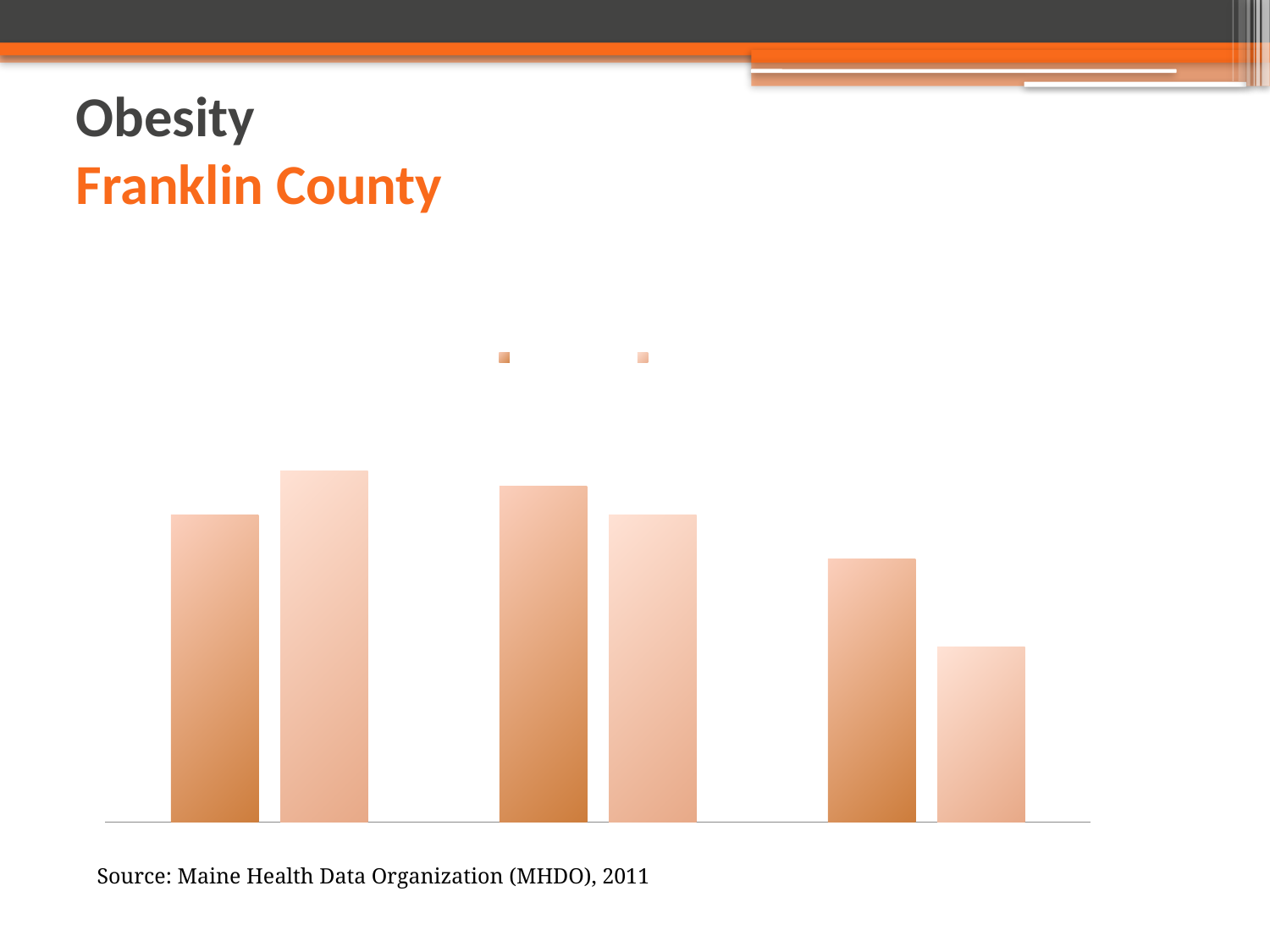
How many bars are plotted in the chart? 6 In the leftmost group of bars, is the darker orange bar or the lighter orange bar taller? the lighter orange bar Which bar is the shortest in the chart? the lighter orange bar in the rightmost group In the middle group of bars, is the darker orange bar or the lighter orange bar taller? the darker orange bar What is the title shown above the chart on the slide? Obesity Franklin County In the rightmost group of bars, is the darker orange bar or the lighter orange bar taller? the darker orange bar How many series does the legend show? 2 How many groups of bars does the chart show along the x axis? 3 Do the darker orange bars rise or fall from left to right across the groups? neither; they rise from the first group to the second, then fall What kind of chart is shown on the slide? bar chart Do the lighter orange bars rise or fall from left to right across the groups? fall Which bar is the tallest in the chart? the lighter orange bar in the leftmost group